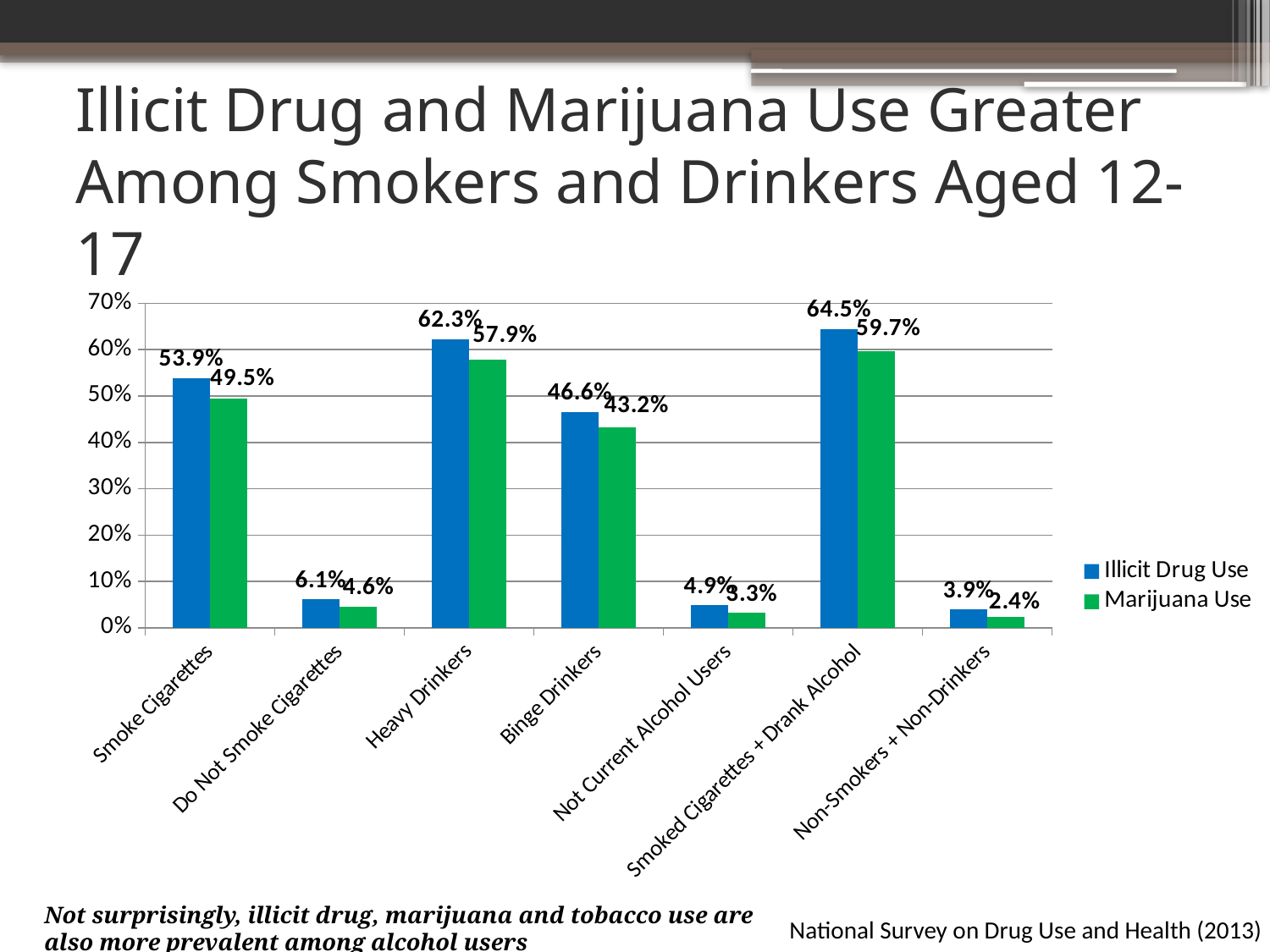
What is the Marijuana Use value for Non-Smokers + Non-Drinkers? 2.4% Which colour represents Marijuana Use in the chart? green What is the difference between the Illicit Drug Use and Marijuana Use values for Binge Drinkers? 3.4% How many series does the legend list? 2 How many categories are shown on the x axis? 7 What is the Illicit Drug Use value for Heavy Drinkers? 62.3% Is the Marijuana Use value for Smoked Cigarettes + Drank Alcohol greater or less than 50%? greater Which category has the highest Illicit Drug Use value? Smoked Cigarettes + Drank Alcohol Which is larger: the Illicit Drug Use value for Smoke Cigarettes or the Illicit Drug Use value for Heavy Drinkers? Heavy Drinkers What is the Marijuana Use value for Smoke Cigarettes? 49.5% What kind of chart is shown on the slide? bar chart Which category has the lowest Marijuana Use value? Non-Smokers + Non-Drinkers